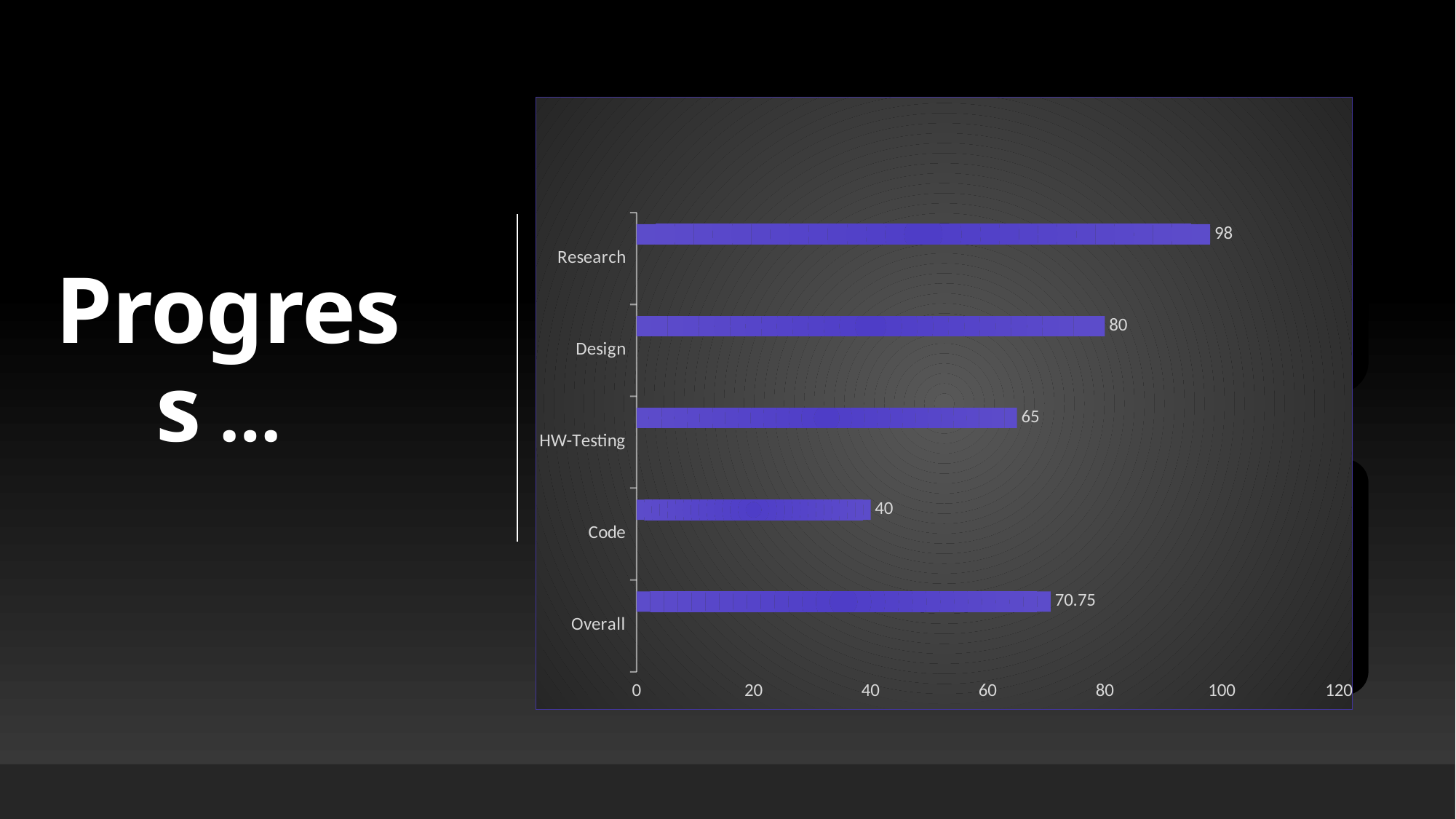
What is the value for HW-Testing? 65 Which category has the highest value? Research What is the value for Overall? 70.75 What is the value for Research? 98 What is the value for Code? 40 Which category has the lowest value? Code What is the difference between the values for Research and Code? 58 How many categories are shown in the chart? 5 Which is larger, the value for Design or the value for Overall? Design Is the value for HW-Testing greater or less than 60? greater What is the value for Design? 80 What kind of chart is shown on the slide? bar chart